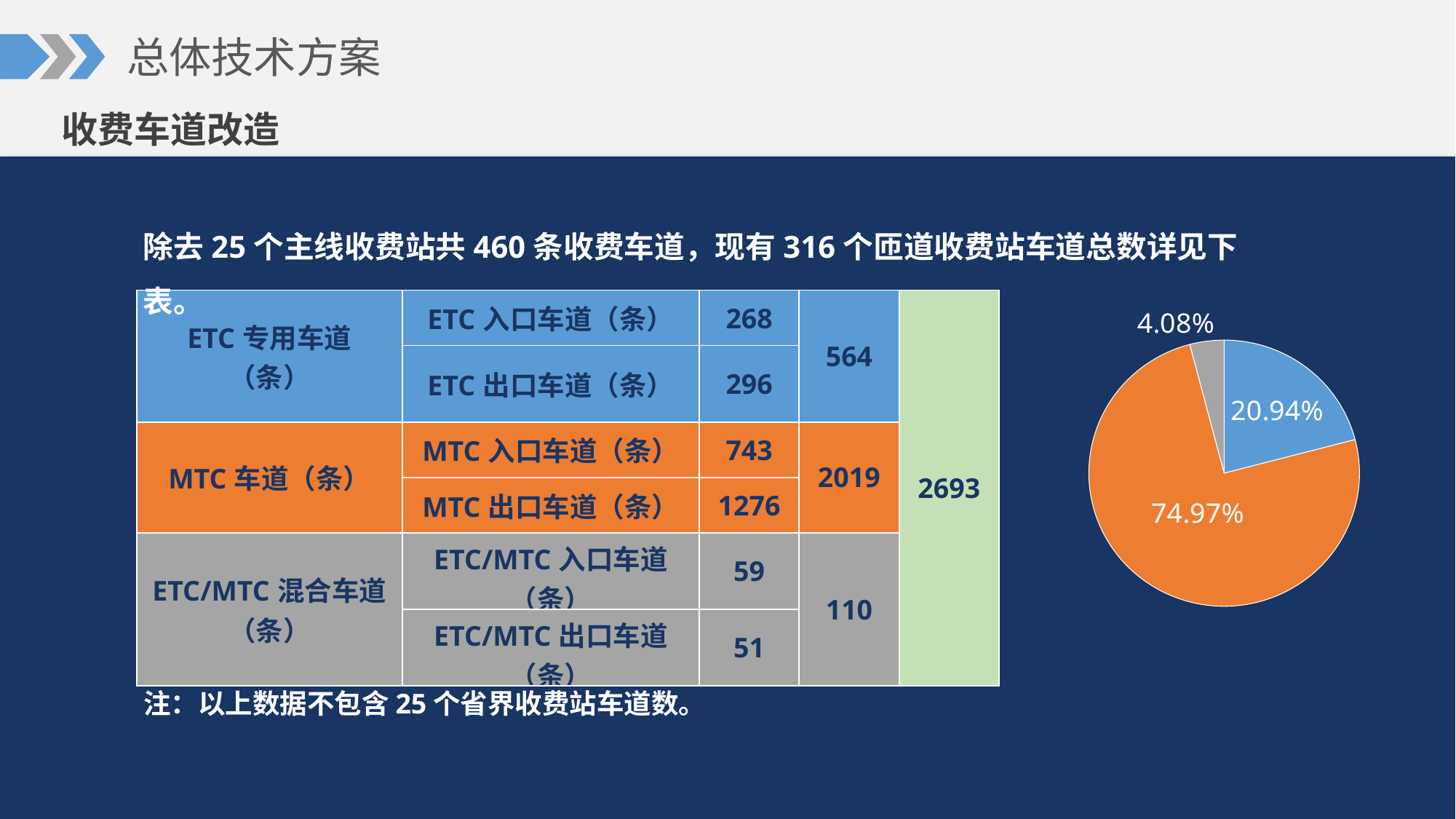
How many slices does the pie chart have? 3 Is the orange slice of the pie chart greater or less than 50% of the pie? greater In the pie chart, which slice is larger, the blue one or the grey one? the blue one (20.94%) Does the pie chart display a legend? No In the pie chart, what is the difference in percentage points between the orange slice and the blue slice? 54.03 What percentage is labelled on the grey slice of the pie chart? 4.08% What is the percentage shown for the smallest slice of the pie chart? 4.08% What kind of chart is shown on the right side of the slide? pie chart What is the percentage shown for the largest slice of the pie chart? 74.97% What percentage is labelled on the orange slice of the pie chart? 74.97% In the pie chart, what is the difference in percentage points between the blue slice and the grey slice? 16.86 What percentage is labelled on the blue slice of the pie chart? 20.94%